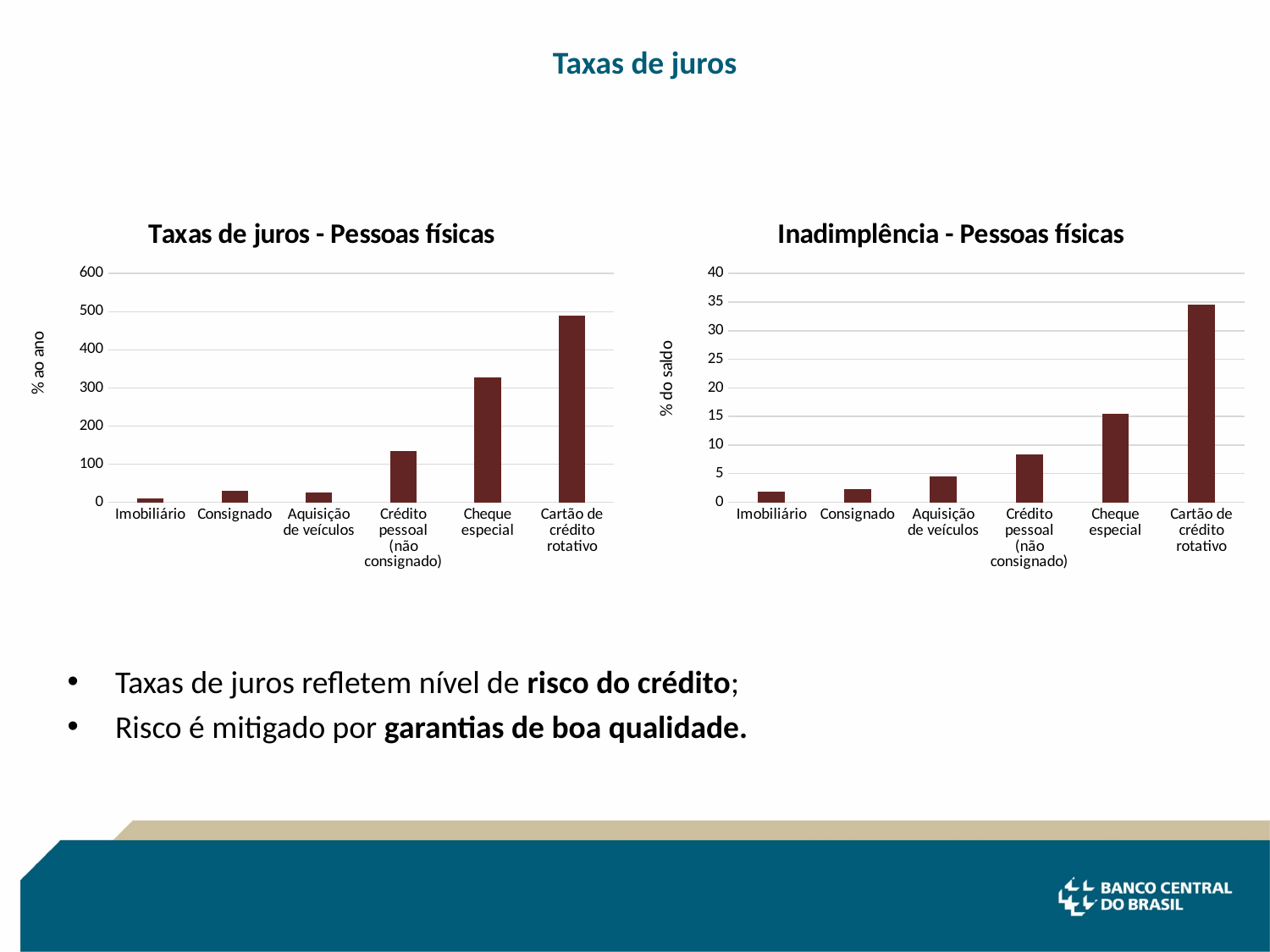
In the chart titled "Taxas de juros - Pessoas físicas", is the value for Cheque especial greater or less than 300? greater In the chart titled "Taxas de juros - Pessoas físicas", which category has the highest value? Cartão de crédito rotativo How many categories are shown in the chart titled "Taxas de juros - Pessoas físicas"? 6 What kind of chart is the chart titled "Inadimplência - Pessoas físicas"? bar chart In the chart titled "Inadimplência - Pessoas físicas", is the value for Cartão de crédito rotativo greater or less than 30? greater In the chart titled "Taxas de juros - Pessoas físicas", which category has the lowest value? Imobiliário In the chart titled "Inadimplência - Pessoas físicas", which is larger, the value for Crédito pessoal (não consignado) or the value for Aquisição de veículos? Crédito pessoal (não consignado) In the chart titled "Inadimplência - Pessoas físicas", do the values generally rise or fall from left to right along the x axis? rise In the chart titled "Taxas de juros - Pessoas físicas", is the value for Crédito pessoal (não consignado) greater or less than 200? less What is the y-axis label of the chart titled "Taxas de juros - Pessoas físicas"? % ao ano In the chart titled "Inadimplência - Pessoas físicas", which category has the highest value? Cartão de crédito rotativo